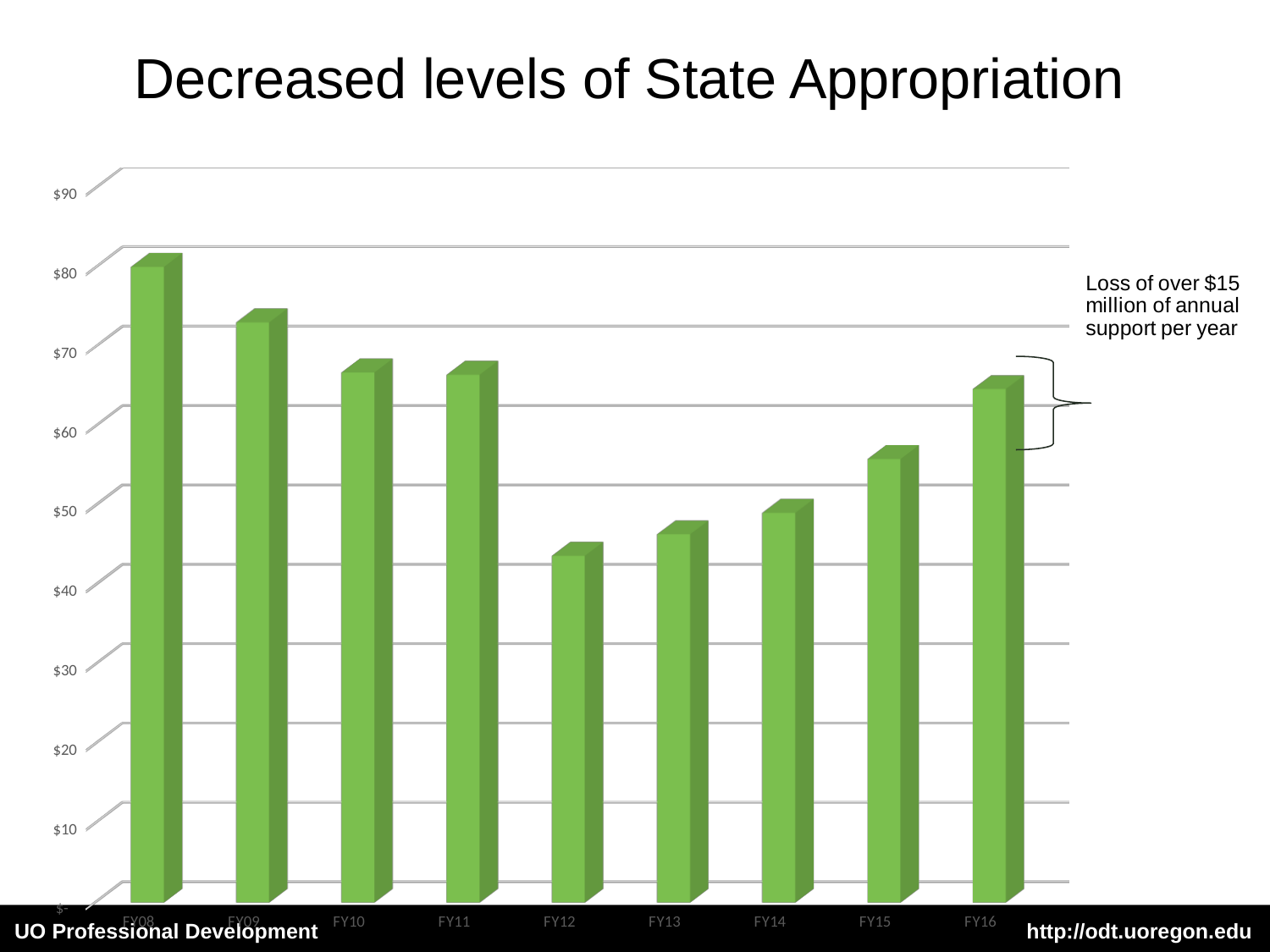
How many fiscal years are plotted on the chart? 9 Is the value for FY16 greater or less than $60? greater Which is larger, the value for FY15 or the value for FY12? FY15 Is the value for FY08 greater or less than $70? greater Is the value for FY12 greater or less than $50? less Which fiscal year has the lowest state appropriation? FY12 Which is larger, the value for FY08 or the value for FY16? FY08 Which fiscal year has the highest state appropriation? FY08 Do the values rise or fall from FY08 to FY12? fall What is the title of the chart? Decreased levels of State Appropriation What kind of chart is shown on the slide? bar chart